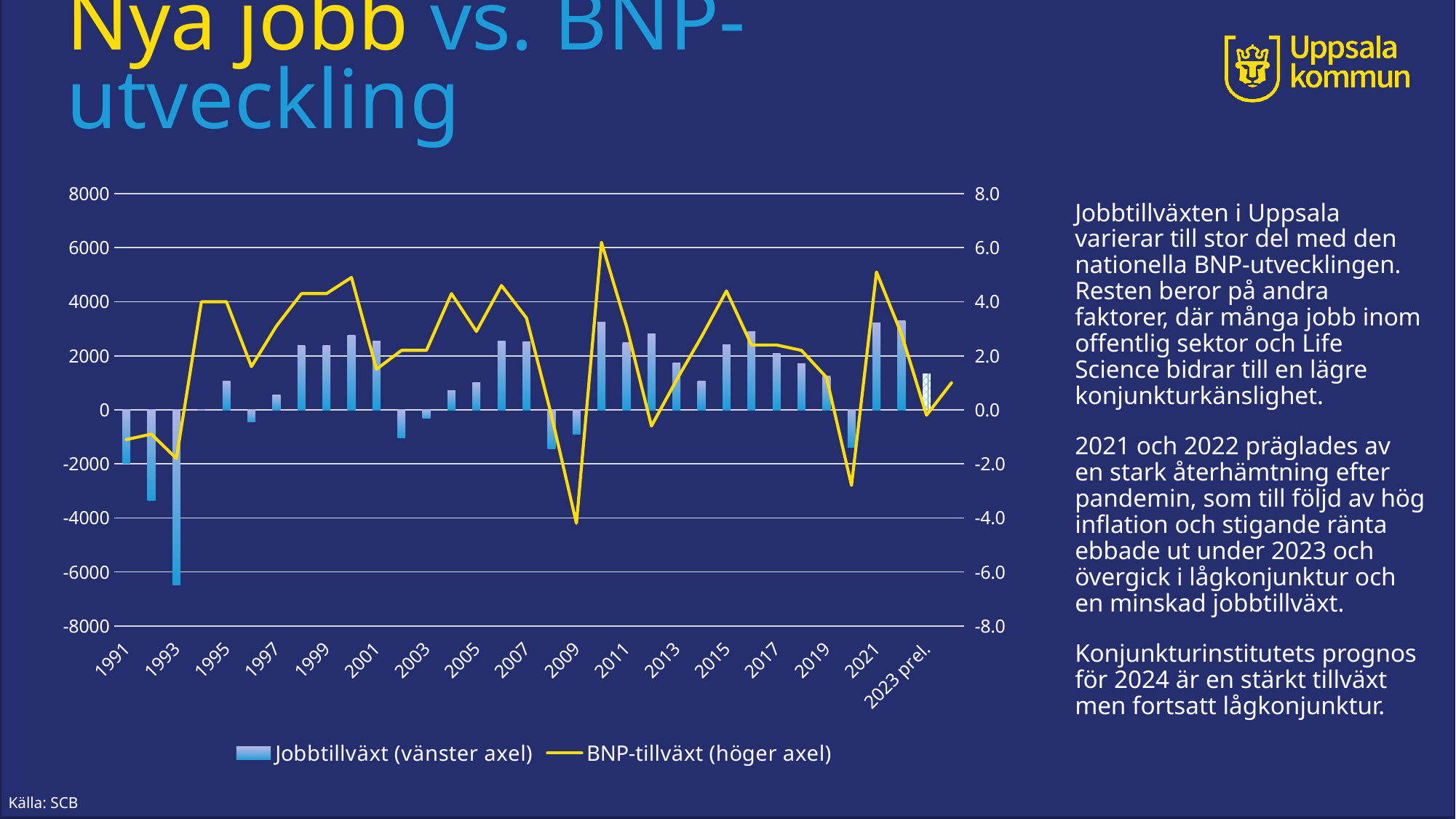
What source is cited for the chart? SCB Is the BNP-tillväxt value for 2021 greater or less than 4.0? greater Which year has the lower Jobbtillväxt bar, 1992 or 1993? 1993 In which year does the BNP-tillväxt line reach its highest point? 2010 In which year is the Jobbtillväxt bar lowest? 1993 Is the Jobbtillväxt value for 1993 greater or less than -4000? less Is the Jobbtillväxt value for 2010 greater or less than 2000? greater Which series is plotted on the right-hand axis according to the legend? BNP-tillväxt (höger axel) How many series does the chart legend list? 2 In which year does the BNP-tillväxt line reach its lowest point? 2009 What kind of chart is shown on the slide? A combined bar and line chart